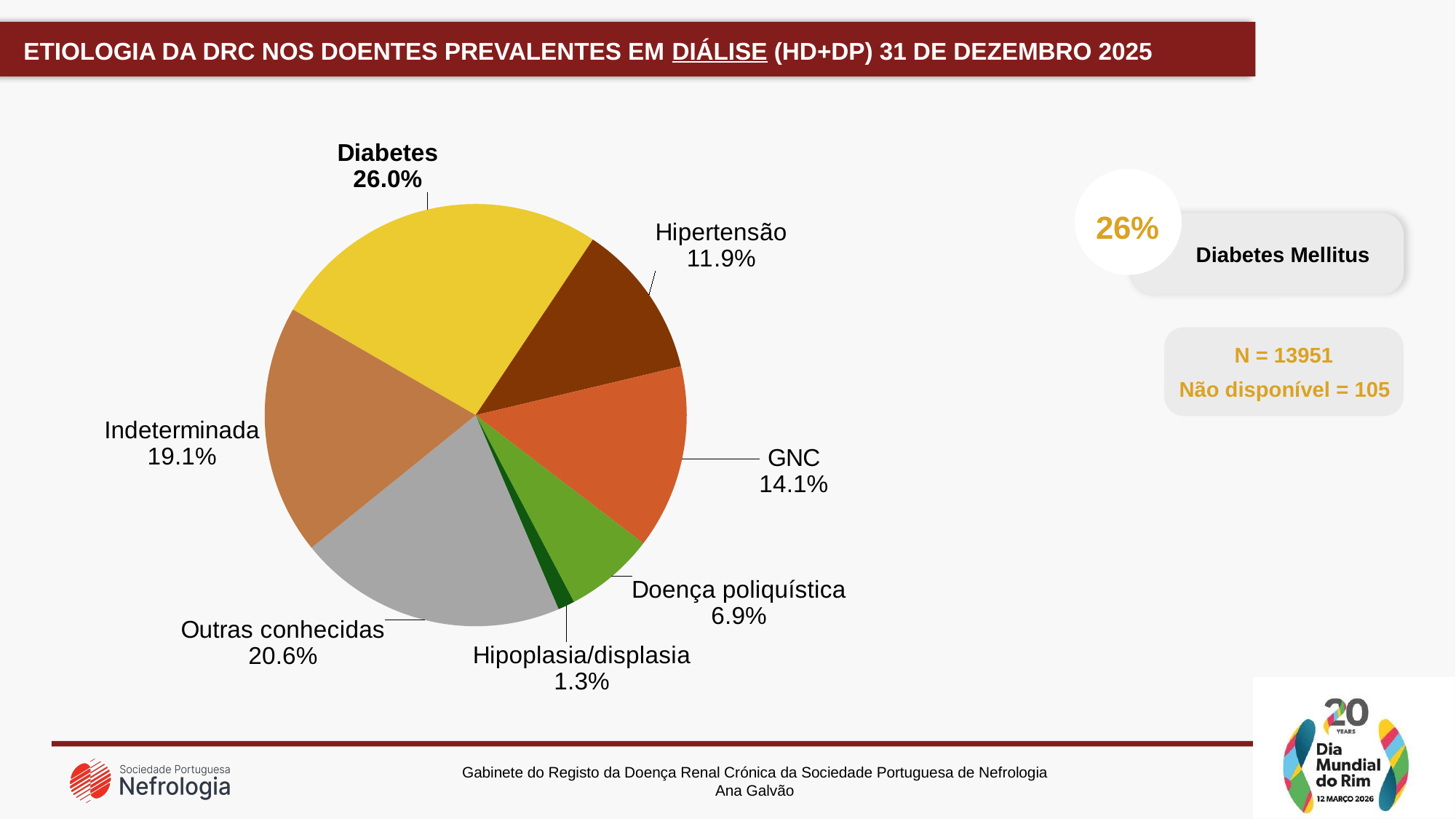
What is the combined percentage of Diabetes and Hipertensão? 37.9% What is the value for Hipoplasia/displasia? 1.3% How many categories are shown in the pie chart? 7 What share does GNC have in the pie chart? 14.1% Which category has the smallest slice of the pie chart? Hipoplasia/displasia What kind of chart is shown on the slide? Pie chart What is the value of N stated on the slide? 13951 What is the difference between the Outras conhecidas and Indeterminada percentages? 1.5% Which is larger, GNC or Doença poliquística? GNC What percentage of the pie chart is Diabetes? 26.0% Which category has the largest slice of the pie chart? Diabetes What is the value shown for Hipertensão? 11.9%